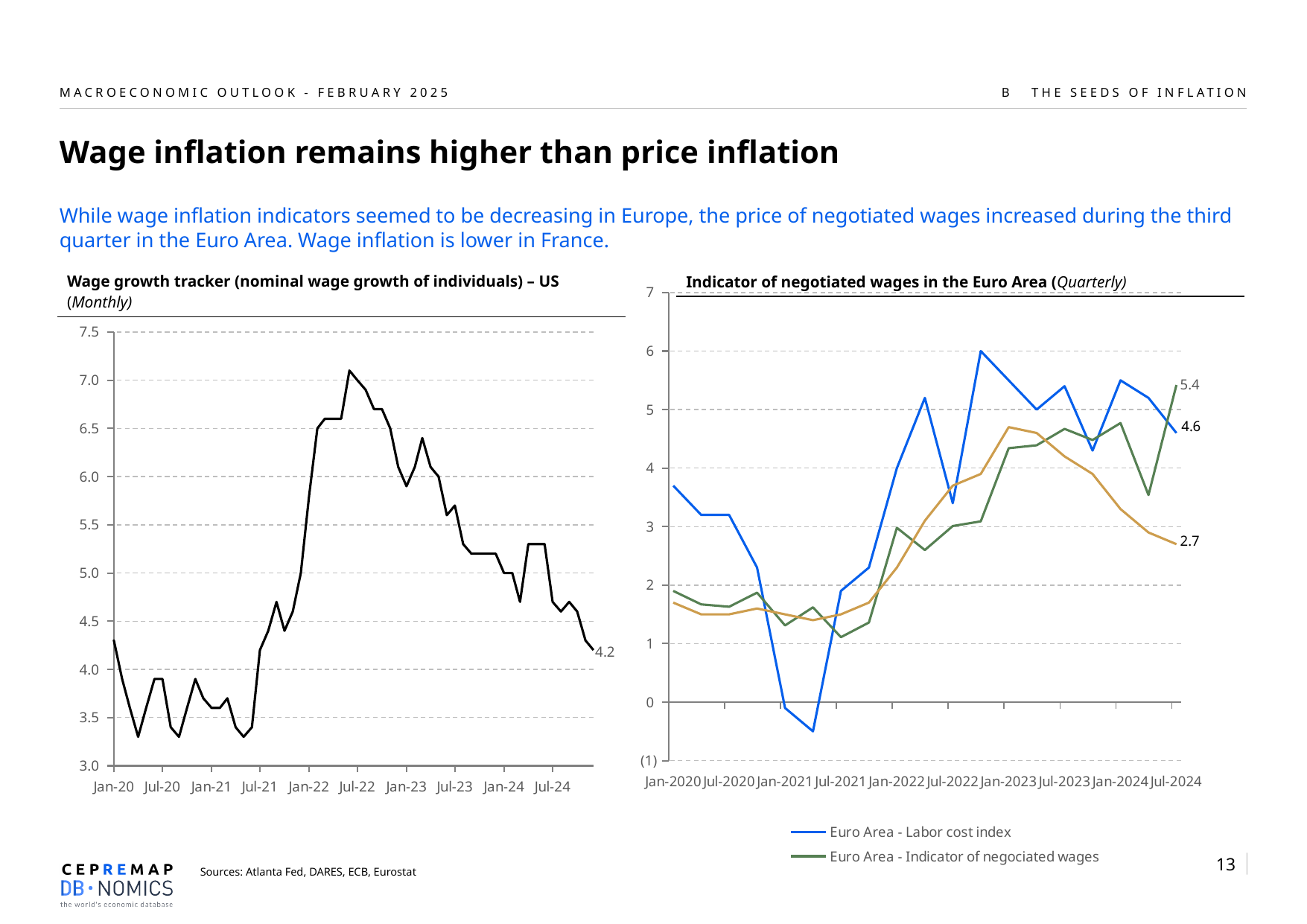
On the right chart (Indicator of negotiated wages in the Euro Area), what is the final value printed for the Euro Area - Labor cost index series? 4.6 On the right chart (Indicator of negotiated wages in the Euro Area), does the Euro Area - Labor cost index rise or fall between Jan-2021 and Jan-2023? rise On the right chart (Indicator of negotiated wages in the Euro Area), is the Euro Area - Labor cost index value at Jan-2020 greater or less than 3? greater On the left chart (US wage growth tracker), what is the value printed at the end of the line? 4.2 How many series does the legend of the right chart (Indicator of negotiated wages in the Euro Area) list? 2 On the right chart (Indicator of negotiated wages in the Euro Area), is the Euro Area - Labor cost index value at Jan-2021 greater or less than 1? less On the right chart (Indicator of negotiated wages in the Euro Area), what is the difference between the final printed values 5.4 and 4.6? 0.8 On the left chart (US wage growth tracker), is the value at Jul-22 greater or less than 6.5? greater What kind of chart is the left chart, 'Wage growth tracker (nominal wage growth of individuals) – US'? line chart On the right chart (Indicator of negotiated wages in the Euro Area), which series has the higher final printed value: Labor cost index or Indicator of negociated wages? Indicator of negociated wages On the right chart (Indicator of negotiated wages in the Euro Area), what is the final value printed for the Euro Area - Indicator of negociated wages series? 5.4